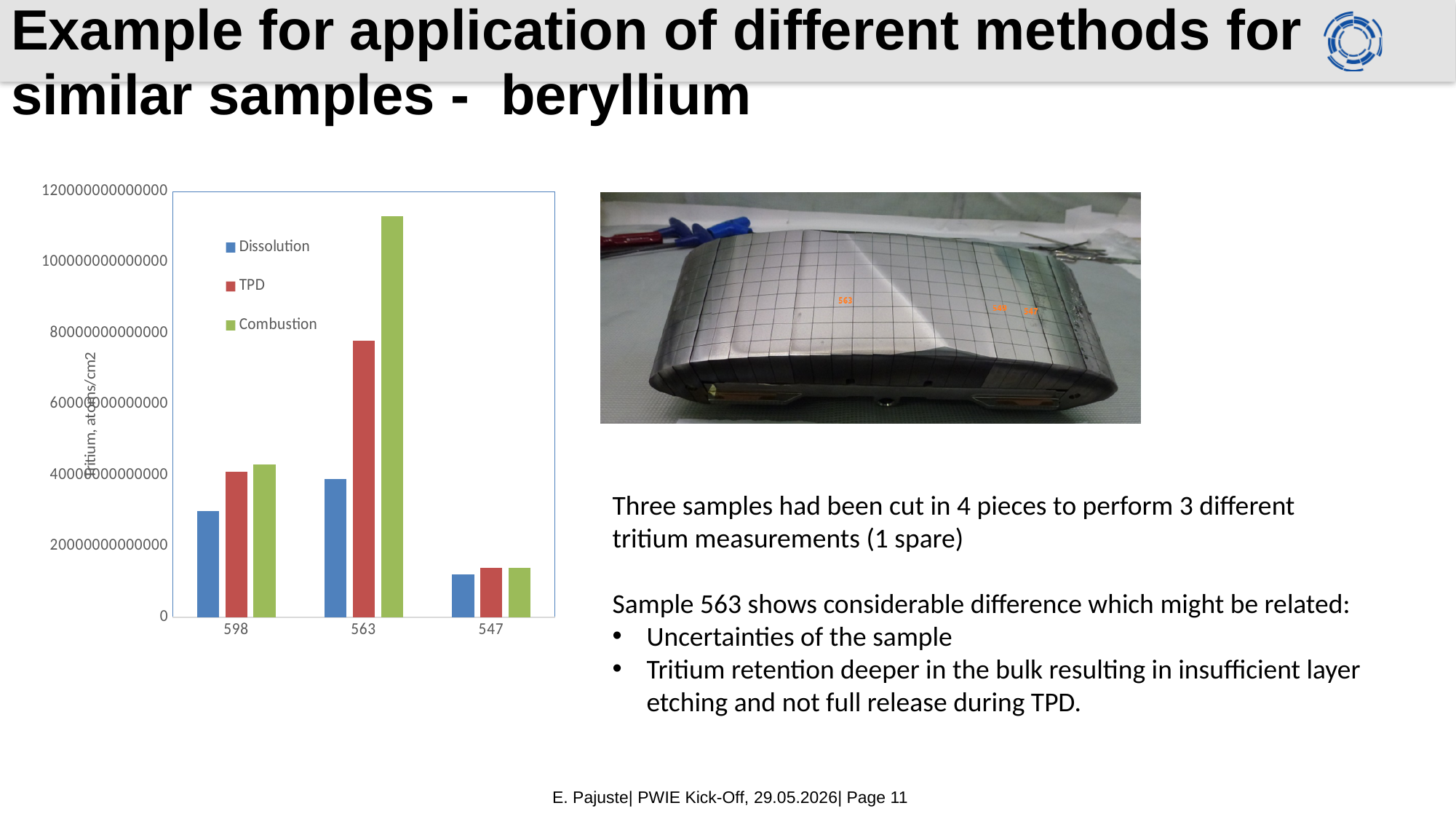
What is the label of the chart's vertical axis? Tritium, atoms/cm2 Is the Dissolution value for sample 547 greater or less than 20000000000000? less Is the TPD value for sample 563 greater or less than 60000000000000? greater What kind of chart is shown on the slide? bar chart Which series are listed in the chart's legend? Dissolution, TPD, Combustion Which sample has the lowest Dissolution value? 547 Which sample has the highest Combustion value? 563 Which is larger for sample 563: the TPD value or the Combustion value? Combustion Is the Combustion value for sample 563 greater or less than 100000000000000? greater How many sample categories are shown on the x axis of the chart? 3 For sample 563, which measurement method gives the highest value? Combustion How many series does the chart's legend list? 3